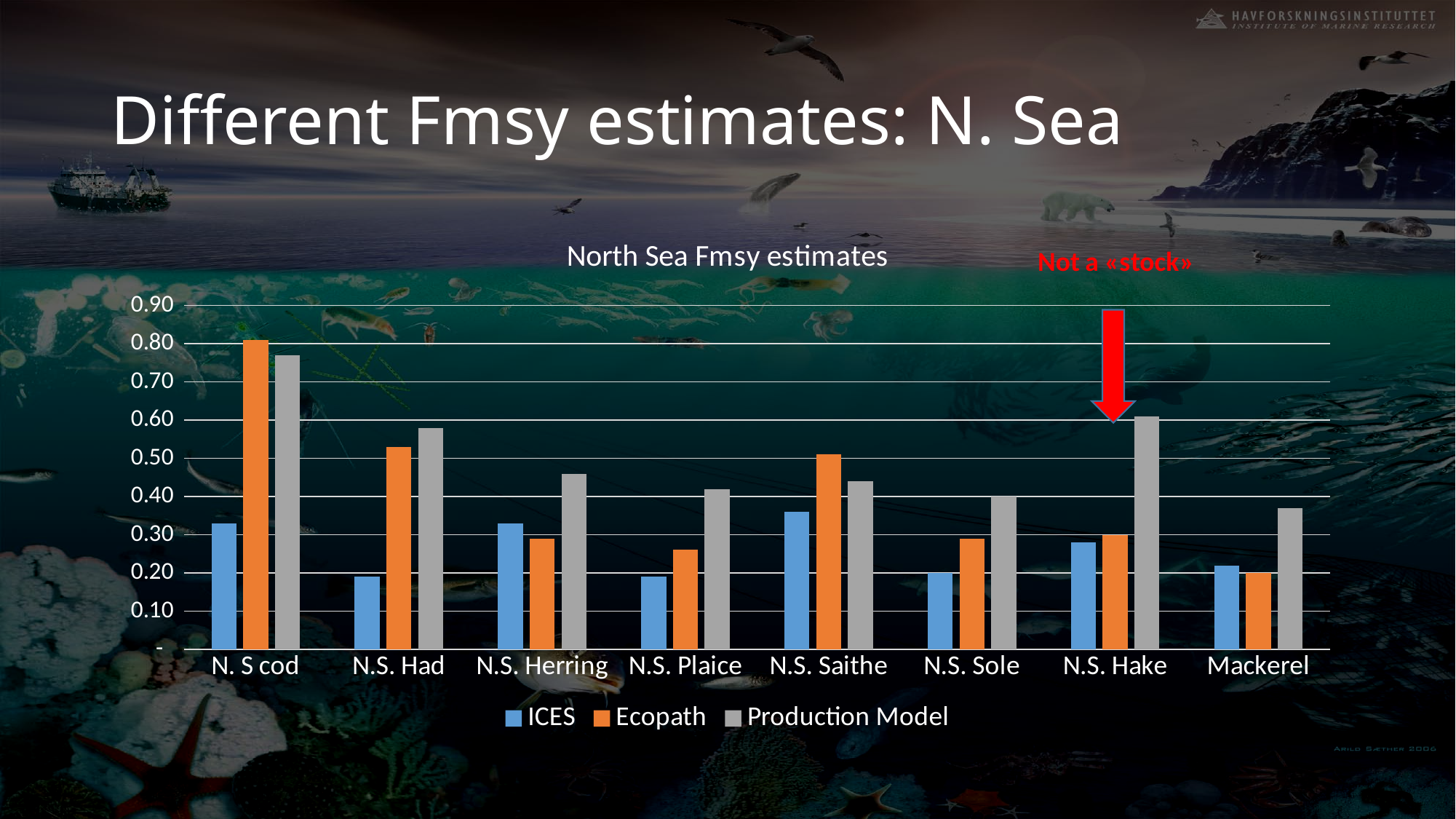
Which category has the lowest Ecopath value? Mackerel How many series does the legend of the North Sea Fmsy estimates chart list? 3 What kind of chart is shown on the slide? bar chart Which category has the highest Production Model value? N. S cod Is the Ecopath value for N. S cod greater or less than 0.70? greater Which category has the highest Ecopath value? N. S cod What is the title of the chart? North Sea Fmsy estimates For N.S. Saithe, which series has the highest value? Ecopath For N.S. Had, which is larger: the Ecopath value or the Production Model value? Production Model Is the Production Model value for N.S. Hake greater or less than 0.50? greater How many stock categories are shown on the x axis of the North Sea Fmsy estimates chart? 8 Which category does the red arrow labelled "Not a «stock»" point to? N.S. Hake